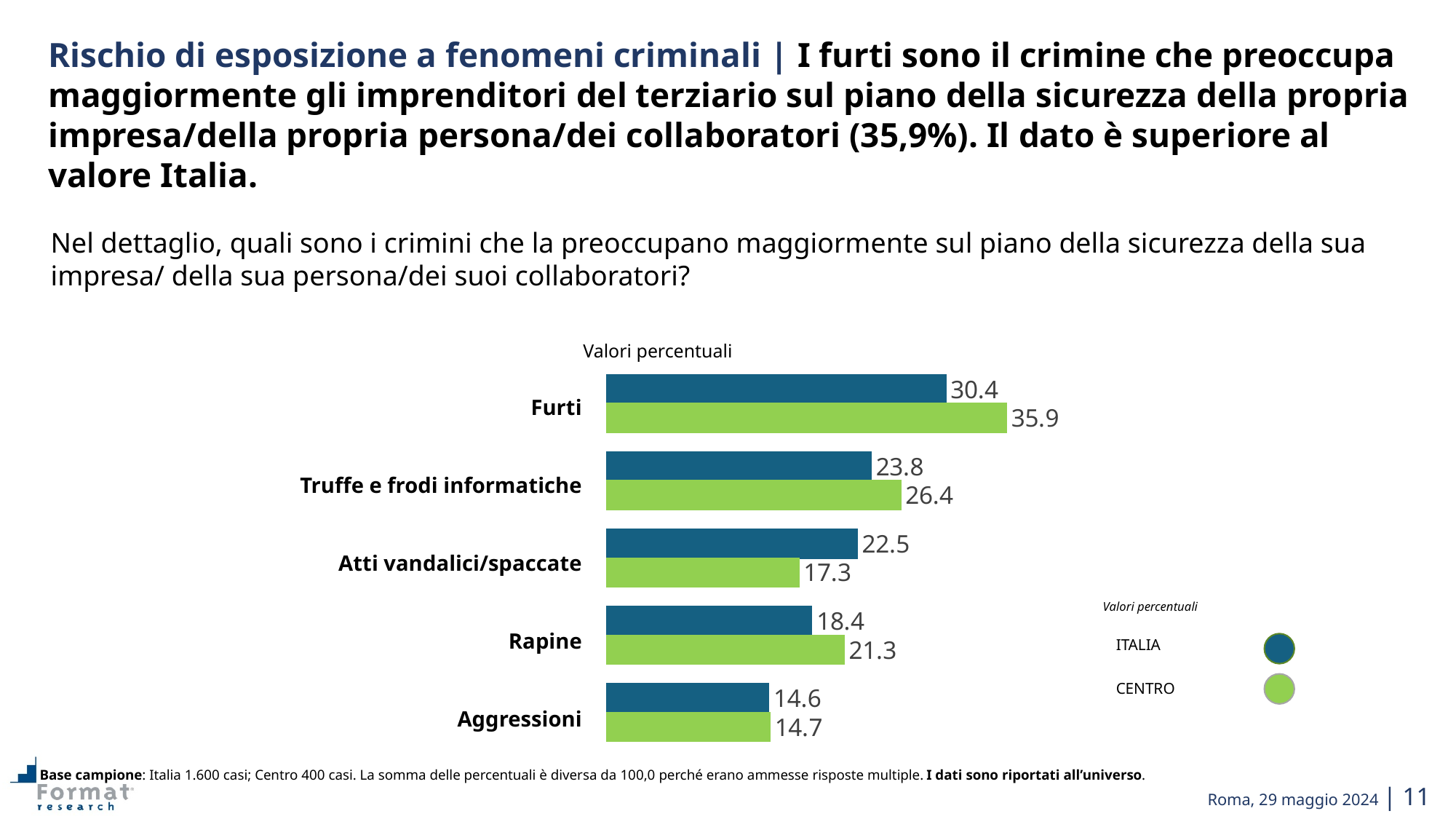
What kind of chart is shown on the slide? Bar chart What is the CENTRO value for Atti vandalici/spaccate? 17.3 For Atti vandalici/spaccate, which is larger: the ITALIA value or the CENTRO value? ITALIA What is the ITALIA value for Truffe e frodi informatiche? 23.8 Which category has the lowest ITALIA value? Aggressioni What is the CENTRO value for Furti? 35.9 How many categories are shown in the chart? 5 What is the ITALIA value for Rapine? 18.4 Which category has the highest CENTRO value? Furti How many series does the legend list? 2 What is the difference between the CENTRO and ITALIA values for Furti? 5.5 Which colour represents the CENTRO series in the chart? Green